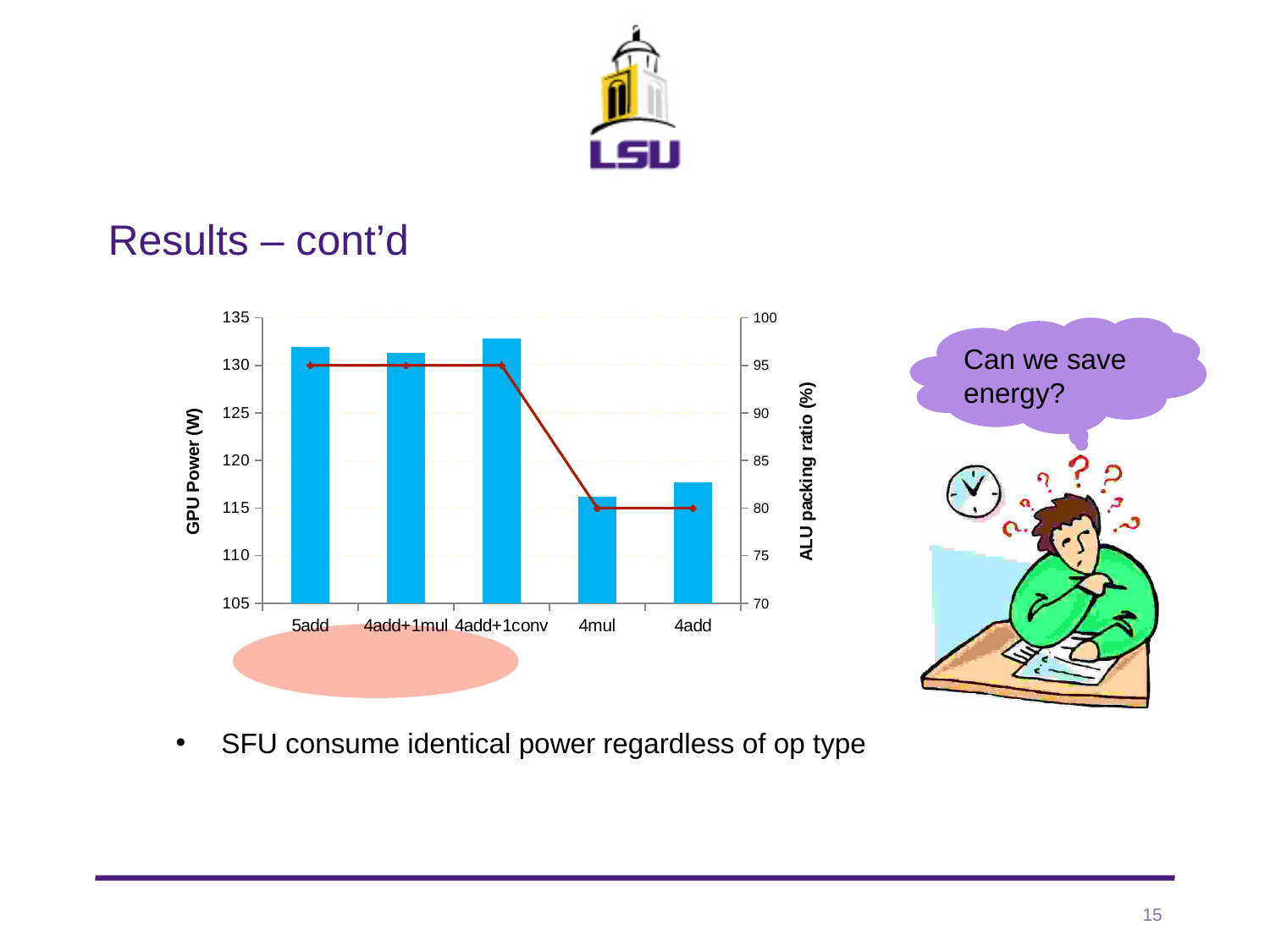
What is the label of the right-hand vertical axis? ALU packing ratio (%) How many categories are shown on the x axis of the chart? 5 What kind of chart is shown on the slide? A bar chart with a line overlay Is the GPU Power (W) value for 4add+1conv greater or less than 130? greater Which category has the lowest GPU Power (W)? 4mul What is the difference in ALU packing ratio (%) between 5add and 4add? 15 What is the ALU packing ratio (%) for 4mul? 80 Does the ALU packing ratio line rise or fall moving from left to right along the x axis? It falls Is the GPU Power (W) value for 5add greater or less than 125? greater Which has the higher GPU Power (W), 5add or 4mul? 5add What is the ALU packing ratio (%) for 5add? 95 Is the GPU Power (W) value for 4mul greater or less than 120? less